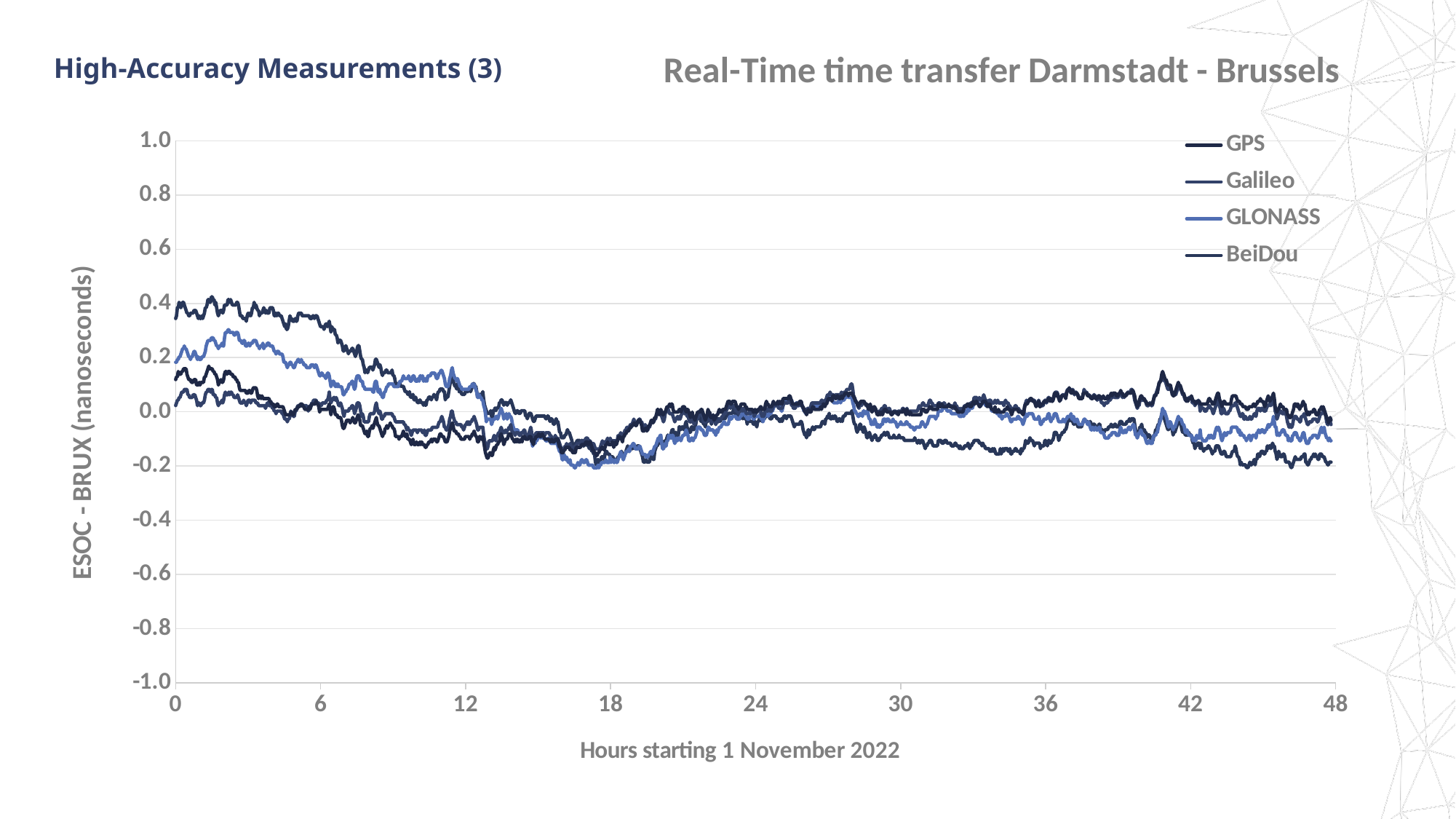
What is the highest value shown on the x axis? 48 What is the title of the chart? Real-Time time transfer Darmstadt - Brussels What is the label of the vertical axis? ESOC - BRUX (nanoseconds) Does the GLONASS line rise or fall between hour 0 and hour 18? fall Is the value for GLONASS at hour 0 greater or less than 0.0? greater How many tick labels are shown on the x axis? 9 What kind of chart is shown on the slide? line chart Is the value for GLONASS at hour 48 greater or less than 0.0? less Is the value for GLONASS at hour 3 greater or less than 0.2? greater How many series does the legend list? 4